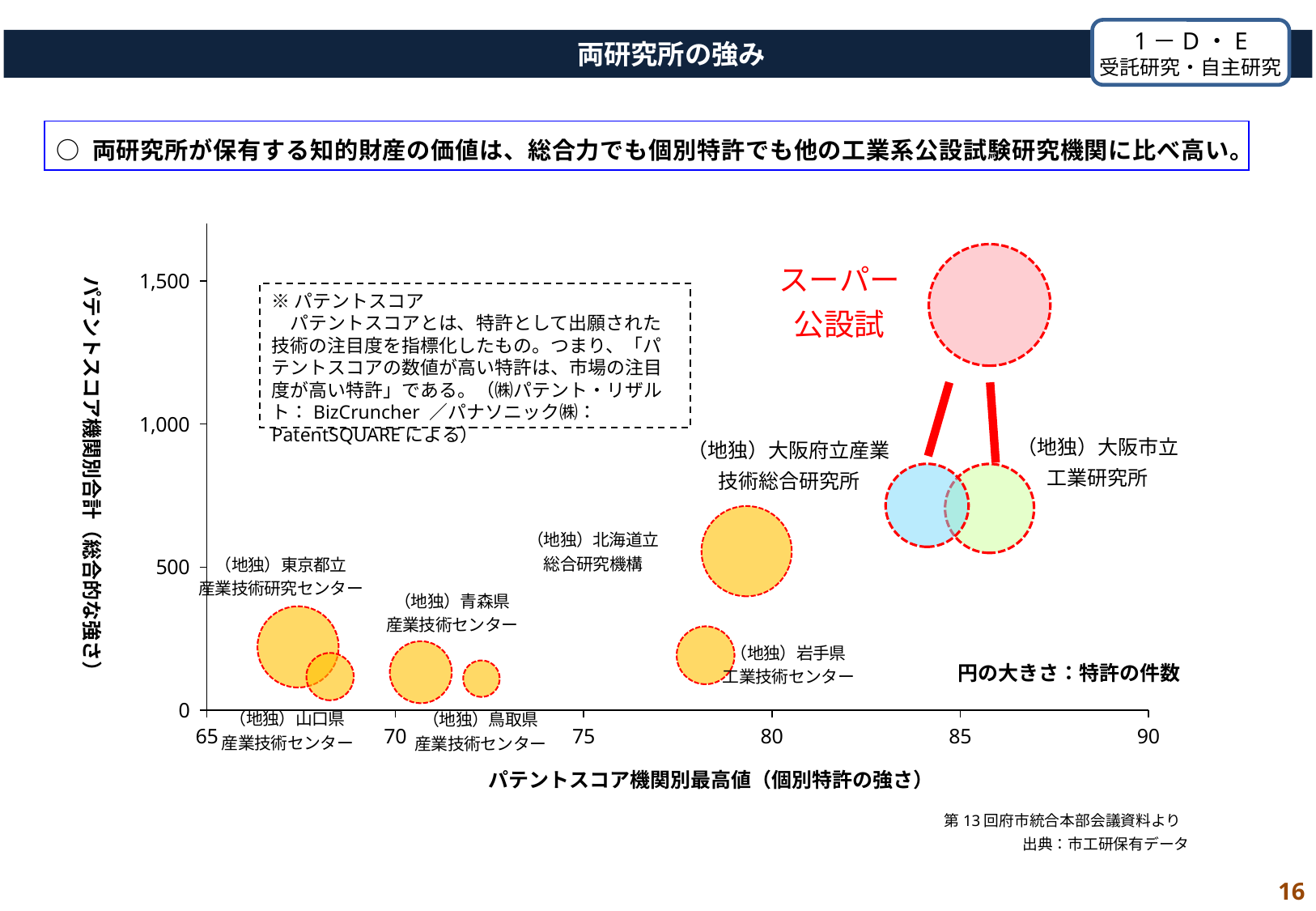
Which has the larger x-axis value: （地独）大阪府立産業技術総合研究所 or （地独）青森県産業技術センター? （地独）大阪府立産業技術総合研究所 Is the y-axis value for （地独）北海道立総合研究機構 greater or less than 1,000? less Is the x-axis value for （地独）鳥取県産業技術センター greater or less than 75? less Is the x-axis value (パテントスコア機関別最高値) for （地独）大阪府立産業技術総合研究所 greater or less than 80? greater Which has the larger y-axis value (パテントスコア機関別合計): （地独）北海道立総合研究機構 or （地独）岩手県工業技術センター? （地独）北海道立総合研究機構 What is the title of the x axis of the chart? パテントスコア機関別最高値（個別特許の強さ） What kind of chart is shown on the slide? Bubble chart According to the chart, what does the size of each circle represent? 特許の件数